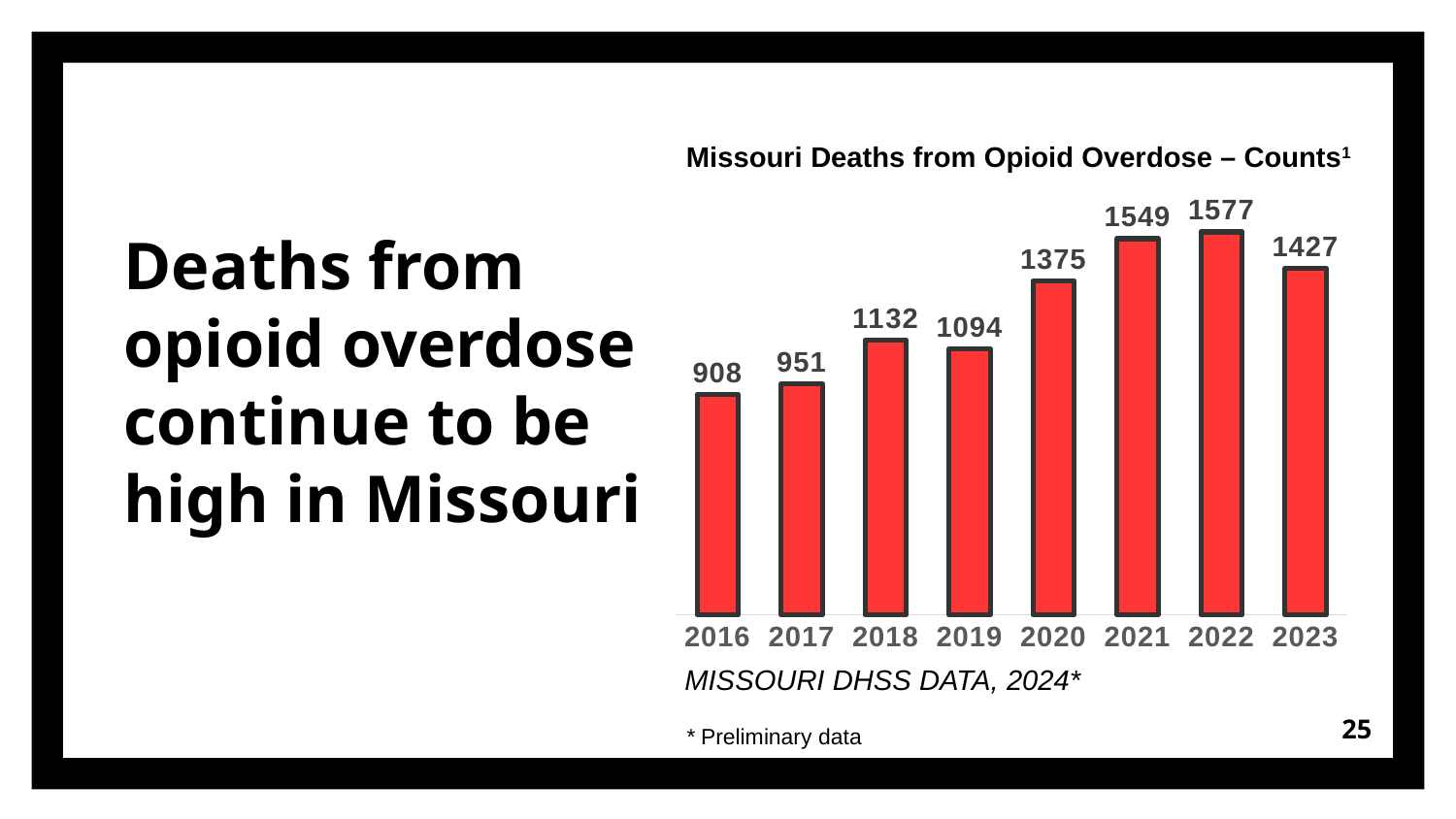
Which year has the highest number of opioid overdose deaths? 2022 Which year has the lowest number of opioid overdose deaths? 2016 What is the difference between the deaths in 2022 and 2023? 150 What is the title of the chart? Missouri Deaths from Opioid Overdose – Counts What is the number of Missouri deaths from opioid overdose in 2023? 1427 What is the number of Missouri deaths from opioid overdose in 2016? 908 Do the death counts rise or fall from 2016 to 2022? Rise What is the number of Missouri deaths from opioid overdose in 2020? 1375 Which year had more opioid overdose deaths, 2018 or 2019? 2018 How many years are shown on the chart? 8 What is the difference between the deaths in 2021 and 2016? 641 What kind of chart is shown on the slide? Bar chart